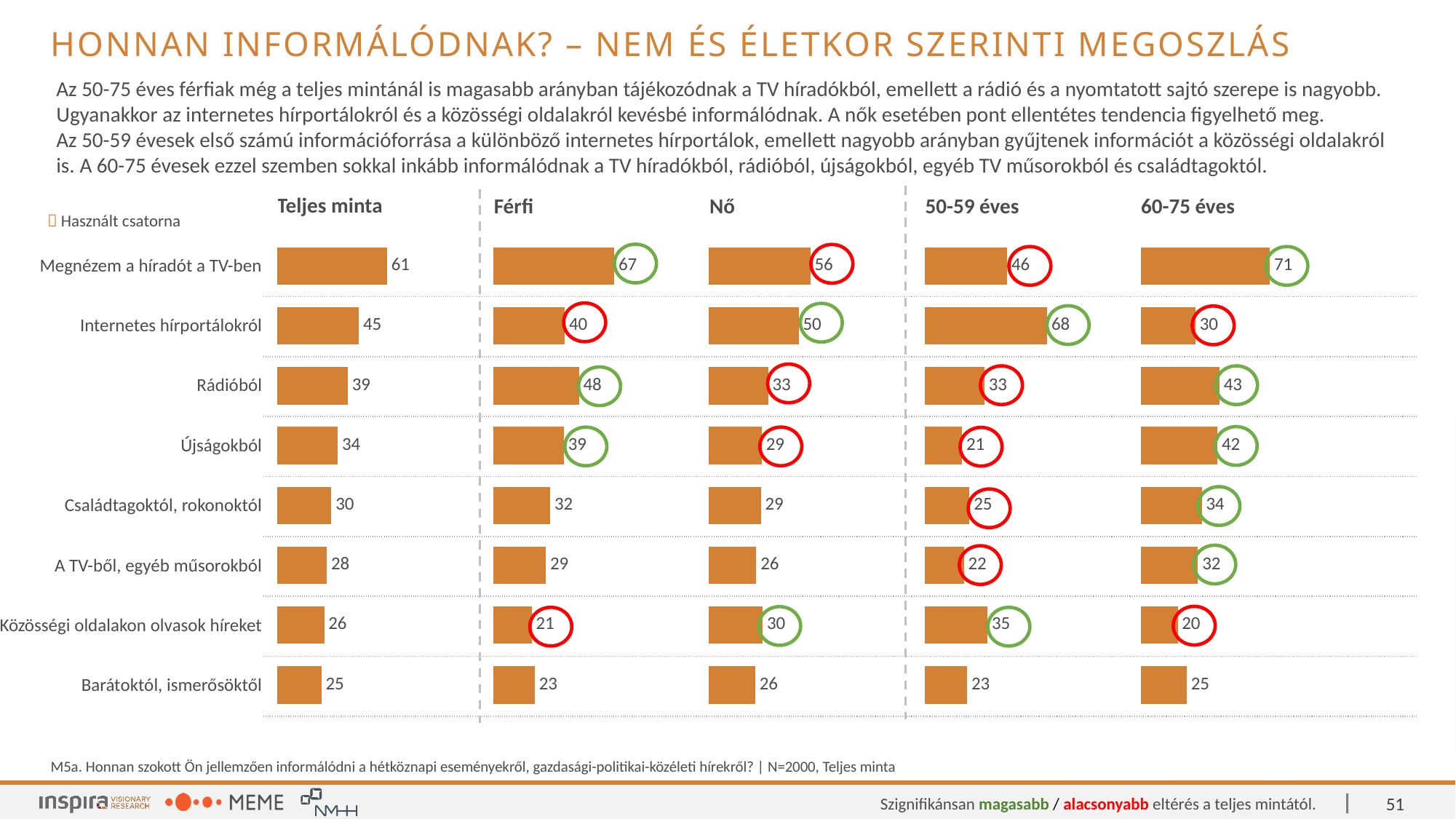
How many categories are shown in the "Férfi" chart? 8 Which is larger: the value for "Közösségi oldalakon olvasok híreket" in the "50-59 éves" chart or in the "60-75 éves" chart? 50-59 éves In the "50-59 éves" chart, which category has the highest value? Internetes hírportálokról In the "60-75 éves" chart, which category has the lowest value? Közösségi oldalakon olvasok híreket In the "Teljes minta" chart, do the values rise or fall going down the list of categories? Fall In the "Teljes minta" chart, what is the value for "Megnézem a híradót a TV-ben"? 61 In the "Nő" chart, what is the value for "Internetes hírportálokról"? 50 In the "Férfi" chart, what is the value for "Rádióból"? 48 In the "Teljes minta" chart, what is the difference between "Megnézem a híradót a TV-ben" and "Internetes hírportálokról"? 16 What kind of chart is used in the "Nő" column? Bar chart How many separate bar charts (columns) are shown on the slide? 5 In the "60-75 éves" chart, what is the value for "Újságokból"? 42